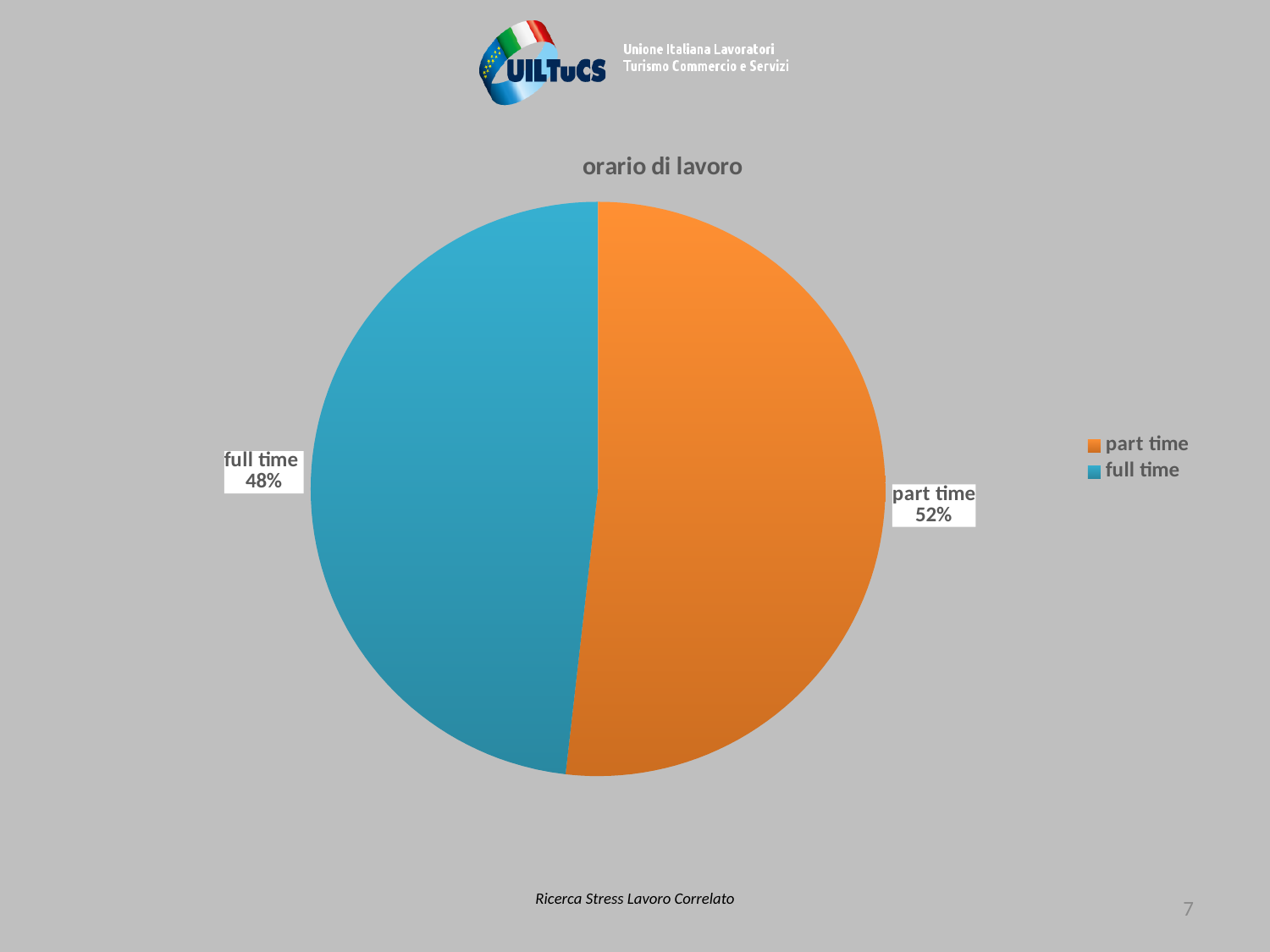
Which slice is the smallest? full time Which slice is the largest? part time What percentage of the pie is part time? 52% How many slices does the pie chart have? 2 What type of chart is shown on the slide? pie chart Which is larger, part time or full time? part time What colour is the part time slice? orange What is the title of the chart? orario di lavoro What is the difference in percentage points between part time and full time? 4 Is the share for full time greater or less than 50%? less How many entries does the legend list? 2 What percentage of the pie is full time? 48%